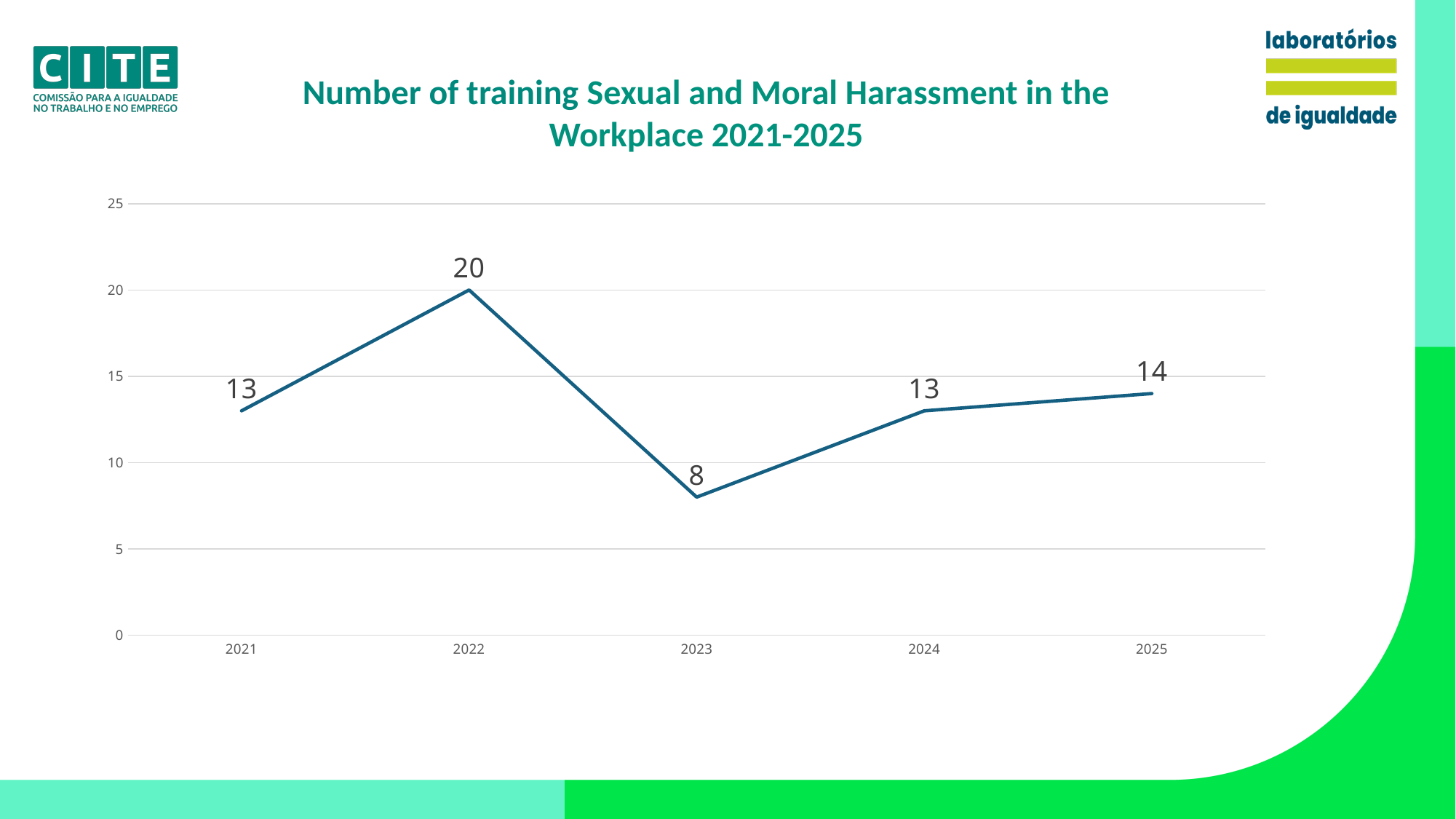
What kind of chart is shown on the slide? line chart Which year has the highest number of trainings? 2022 What is the number of trainings in 2022? 20 What is the difference between the number of trainings in 2022 and 2023? 12 What is the number of trainings in 2023? 8 Do the values rise or fall from 2023 to 2025? rise What is the number of trainings in 2025? 14 What is the title of the chart? Number of training Sexual and Moral Harassment in the Workplace 2021-2025 Which year has the lowest number of trainings? 2023 Is the value for 2023 greater or less than 10? less Which year has more trainings, 2021 or 2025? 2025 How many years are plotted on the chart? 5